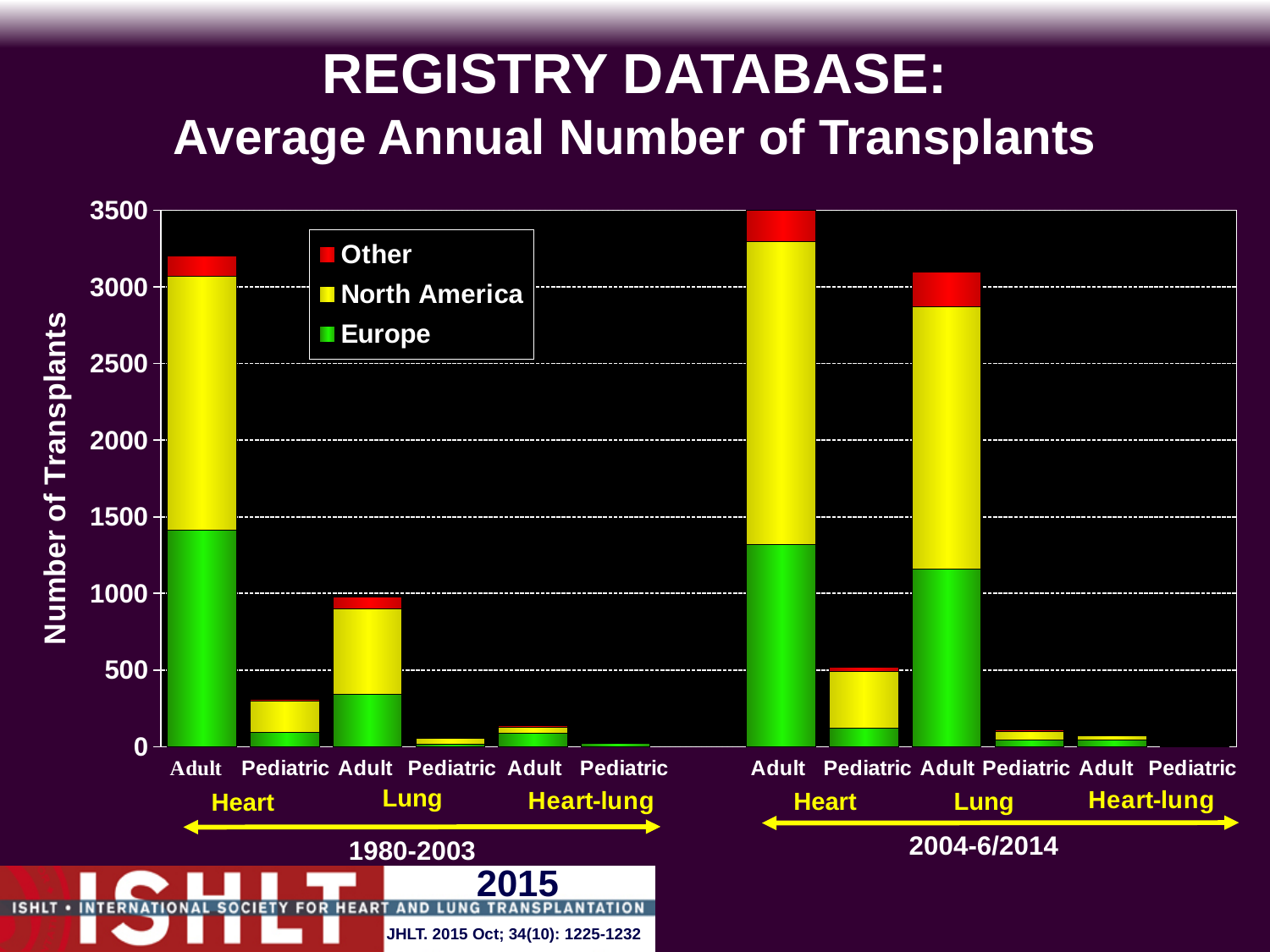
Which is larger: the Adult Lung total for 1980-2003 or the Adult Lung total for 2004-6/2014? 2004-6/2014 What are the three entries in the legend? Other, North America, Europe Is the total for Adult Heart transplants in 1980-2003 greater or less than 3000? greater How many series does the legend list? 3 What kind of chart is shown on the slide? Stacked bar chart What is the title of the vertical axis? Number of Transplants How many stacked bars are plotted in the chart? 12 Which is larger in 2004-6/2014: the Adult Heart total or the Adult Lung total? Adult Heart Is the total for Pediatric Heart transplants in 1980-2003 greater or less than 500? less Is the Europe portion of the Adult Heart bar for 1980-2003 greater or less than 1000? greater Which bar is the tallest in the chart? Adult Heart, 2004-6/2014